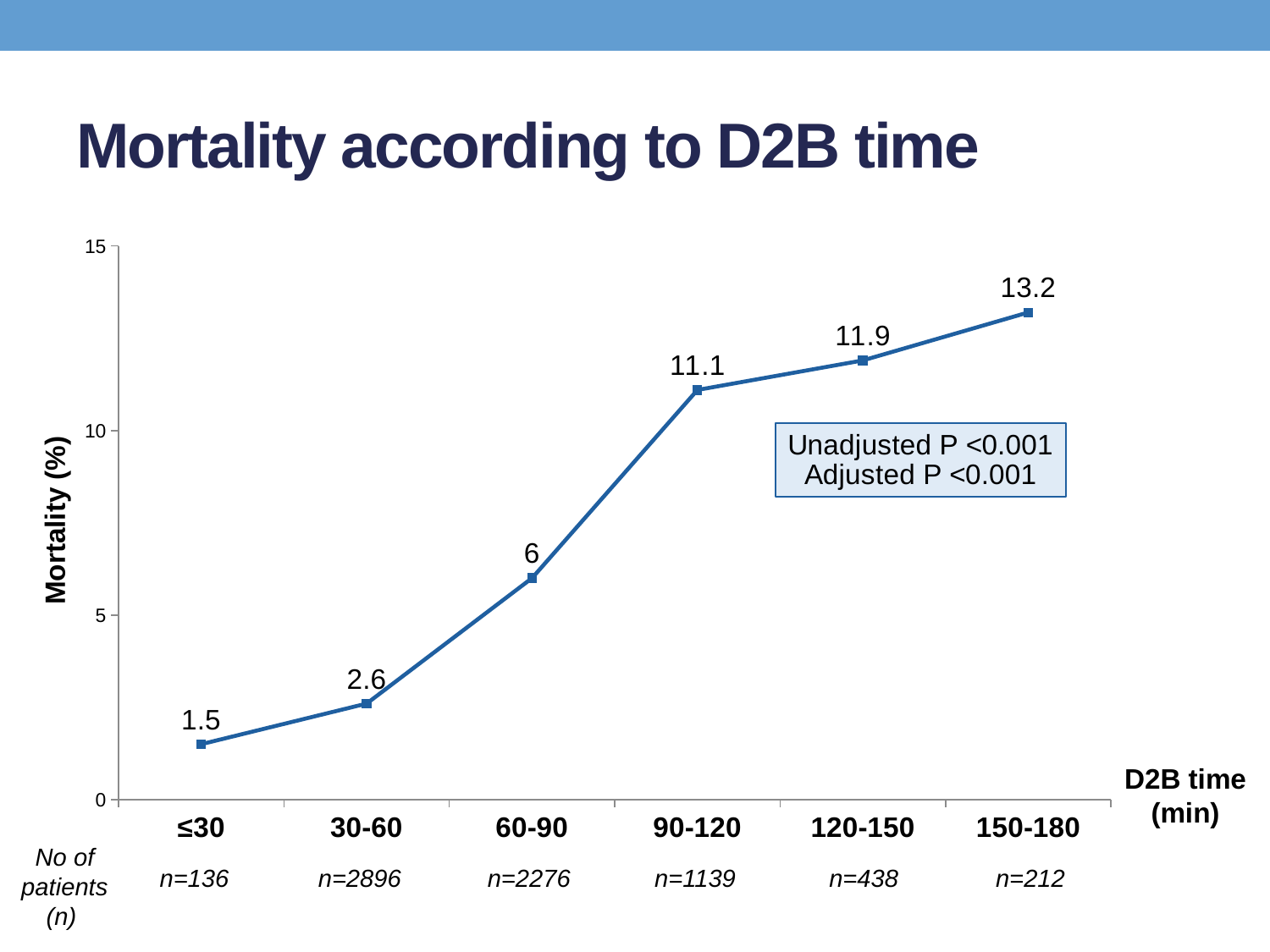
Which has higher mortality, the 30-60 group or the 90-120 group? 90-120 What is the mortality (%) for the 120-150 min D2B time group? 11.9 What is the mortality (%) for the 60-90 min D2B time group? 6 What is the difference in mortality (%) between the 150-180 and 90-120 D2B time groups? 2.1 What kind of chart is shown on the slide? Line chart What is the mortality (%) for the ≤30 min D2B time group? 1.5 Which D2B time group has the highest mortality? 150-180 Does mortality rise or fall as D2B time increases along the x axis? Rise How many D2B time groups are plotted on the chart? 6 What is the number of patients (n) in the 30-60 min D2B time group? n=2896 Which D2B time group has the lowest mortality? ≤30 What is the difference in mortality (%) between the 60-90 and 30-60 D2B time groups? 3.4